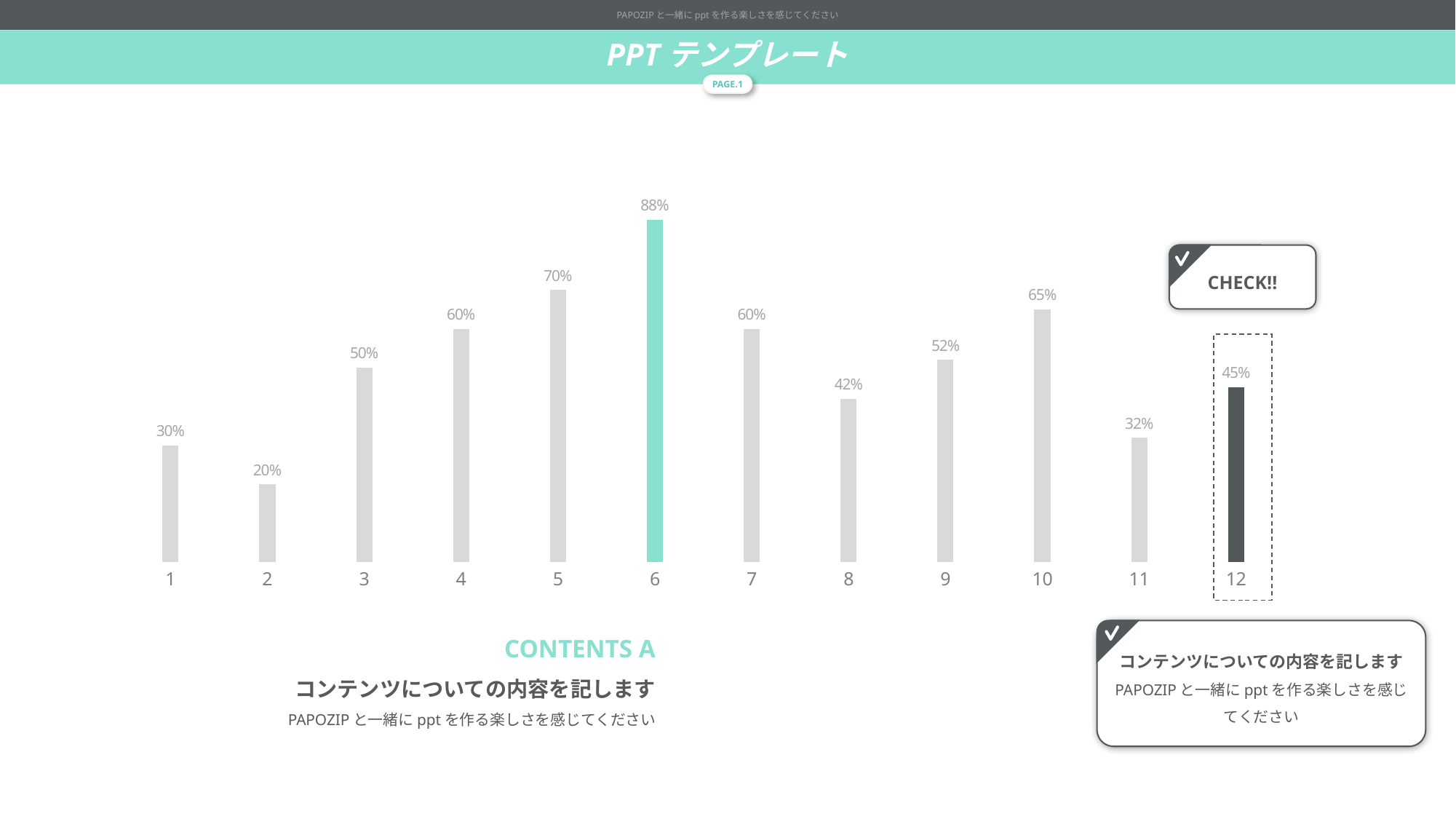
What is the value for category 9? 52% Which category has the lowest value? 2 What is the difference between the values for category 10 and category 11? 33% What kind of chart is shown on the slide? bar chart How many categories are shown on the x axis? 12 Which category's bar is highlighted in teal? 6 What is the difference between the values for category 6 and category 5? 18% What is the value for category 6? 88% What is the value for category 12? 45% Do the values rise or fall from category 1 to category 6? rise Which is larger, the value for category 8 or the value for category 9? 9 Which category has the highest value? 6